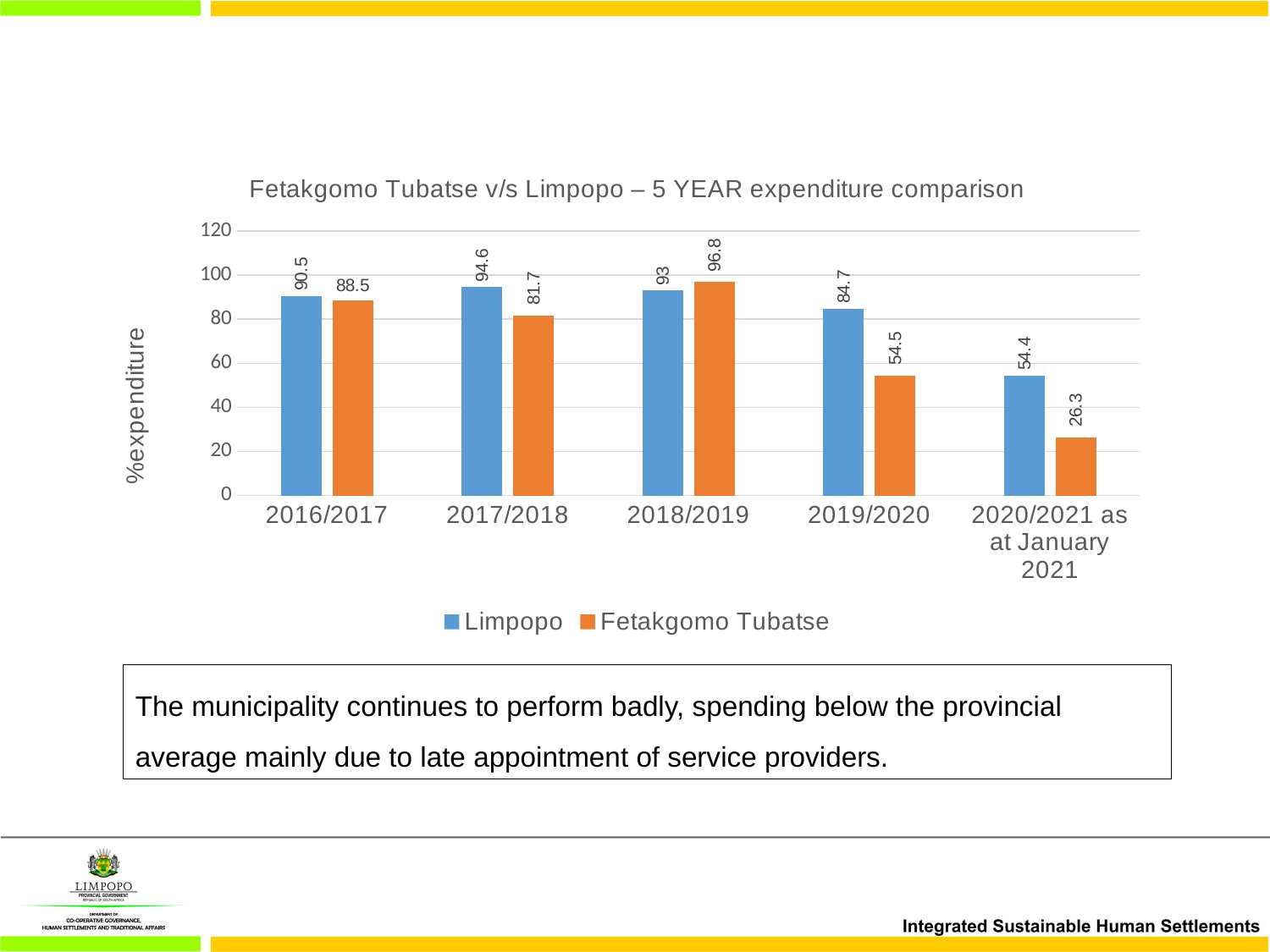
In which year is the Fetakgomo Tubatse value highest? 2018/2019 How many year categories are shown on the x axis? 5 In which year is the Limpopo value lowest? 2020/2021 as at January 2021 What is the title of the chart? Fetakgomo Tubatse v/s Limpopo – 5 YEAR expenditure comparison Which is larger in 2018/2019, the Limpopo value or the Fetakgomo Tubatse value? Fetakgomo Tubatse How many series does the legend list? 2 What kind of chart is shown on the slide? bar chart What is the Fetakgomo Tubatse value for 2020/2021 as at January 2021? 26.3 What is the Fetakgomo Tubatse value for 2019/2020? 54.5 Is the Fetakgomo Tubatse value for 2020/2021 as at January 2021 greater or less than 40? less What is the difference between the Limpopo and Fetakgomo Tubatse values in 2017/2018? 12.9 What is the Limpopo value for 2016/2017? 90.5